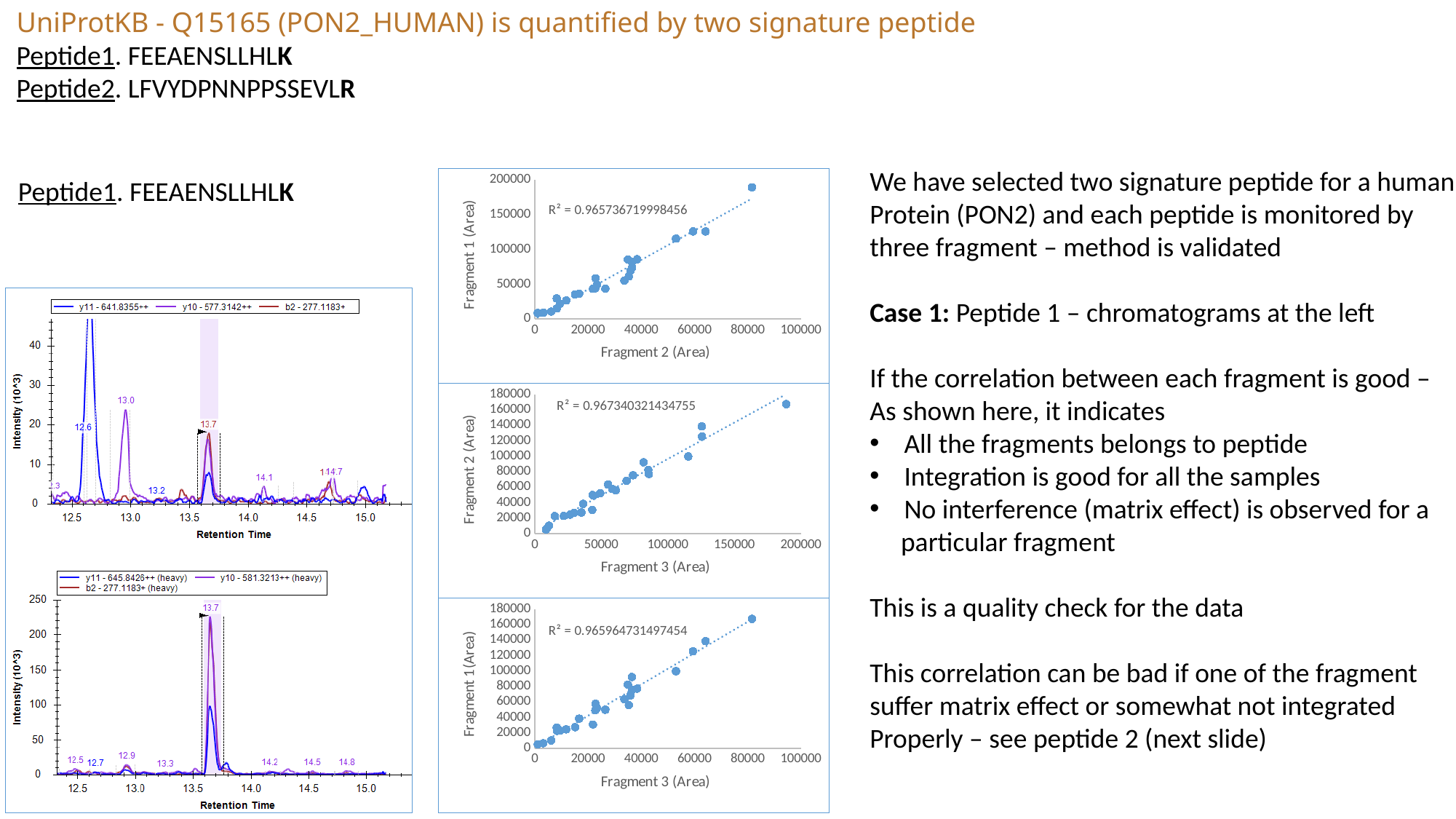
Among the three scatter charts in the middle column, which one has the highest printed R² value? the middle chart (Fragment 2 vs Fragment 3), R² = 0.967340321434755 In the middle scatter chart (Fragment 2 vs Fragment 3), do the plotted values rise or fall as Fragment 3 area increases? rise What kind of chart is the top chart in the middle column (Fragment 1 vs Fragment 2)? scatter chart In the top scatter chart in the middle column, what is the label of the x axis? Fragment 2 (Area) In the top scatter chart in the middle column, what R² value is printed? R² = 0.965736719998456 How many series does the legend of the top chromatogram on the left list? 3 In the bottom chromatogram on the left, is the intensity of the peak at 13.7 greater or less than 200? greater In the bottom scatter chart (Fragment 1 vs Fragment 3), what R² value is printed? R² = 0.965964731497454 In the bottom scatter chart in the middle column, what is the label of the y axis? Fragment 1 (Area) In the bottom chromatogram on the left, at what retention time is the tallest, highlighted peak labelled? 13.7 In the middle scatter chart (Fragment 2 vs Fragment 3), what R² value is printed? R² = 0.967340321434755 How many series does the legend of the bottom chromatogram on the left (heavy) list? 3